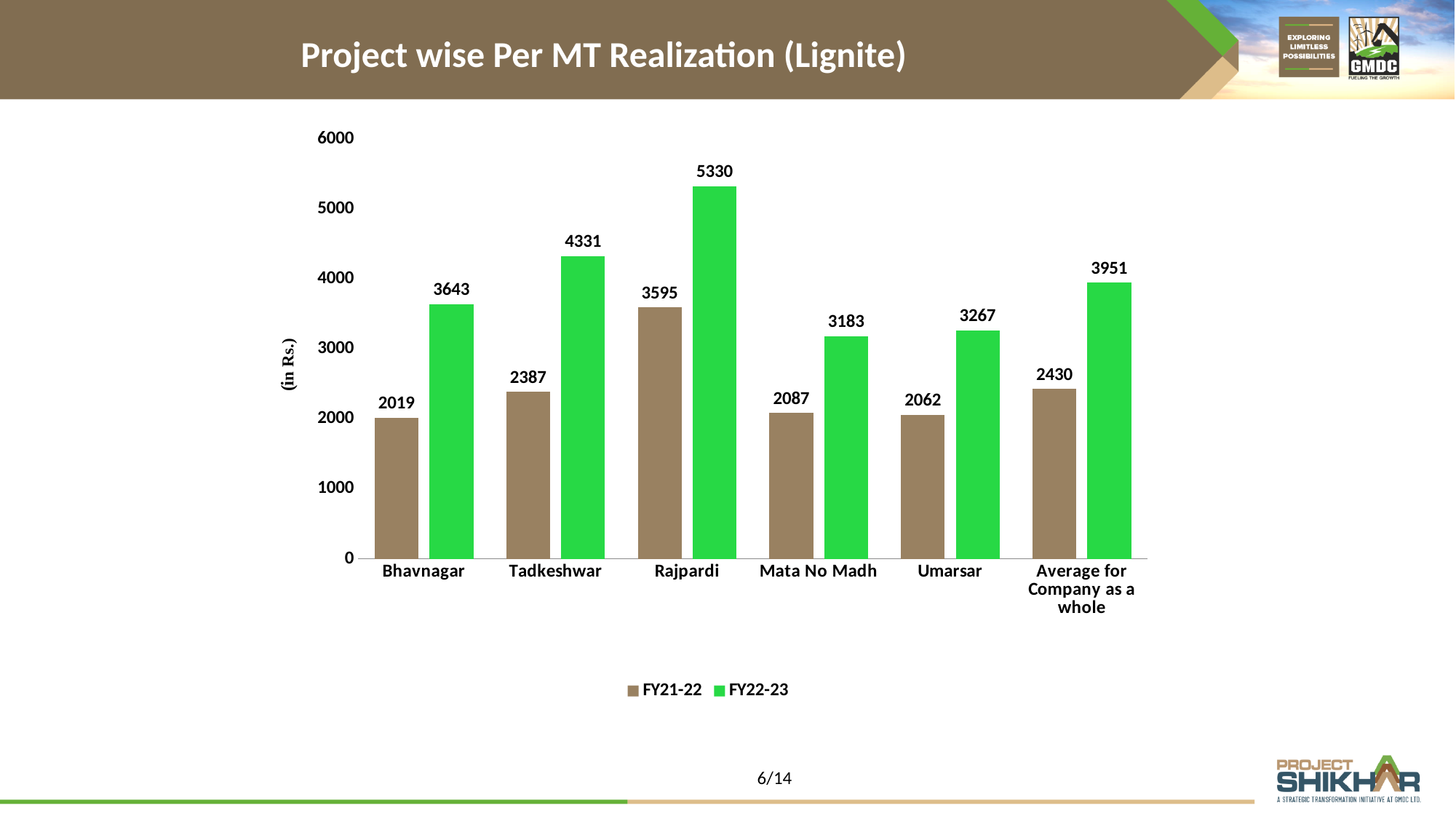
Which is larger: the FY21-22 value for Rajpardi or the FY22-23 value for Mata No Madh? FY21-22 value for Rajpardi What is the FY22-23 per MT realization for Rajpardi? 5330 What unit is shown on the vertical axis label? in Rs. What is the FY22-23 value for Average for Company as a whole? 3951 What is the FY21-22 per MT realization for Bhavnagar? 2019 Which category has the lowest FY21-22 per MT realization? Bhavnagar What kind of chart is shown on the slide? Bar chart What is the difference between the FY22-23 and FY21-22 values for Tadkeshwar? 1944 How many categories are shown on the x axis? 6 How many series does the legend list? 2 Is the FY22-23 value for Umarsar greater or less than 3000? greater Which project has the highest FY22-23 per MT realization? Rajpardi